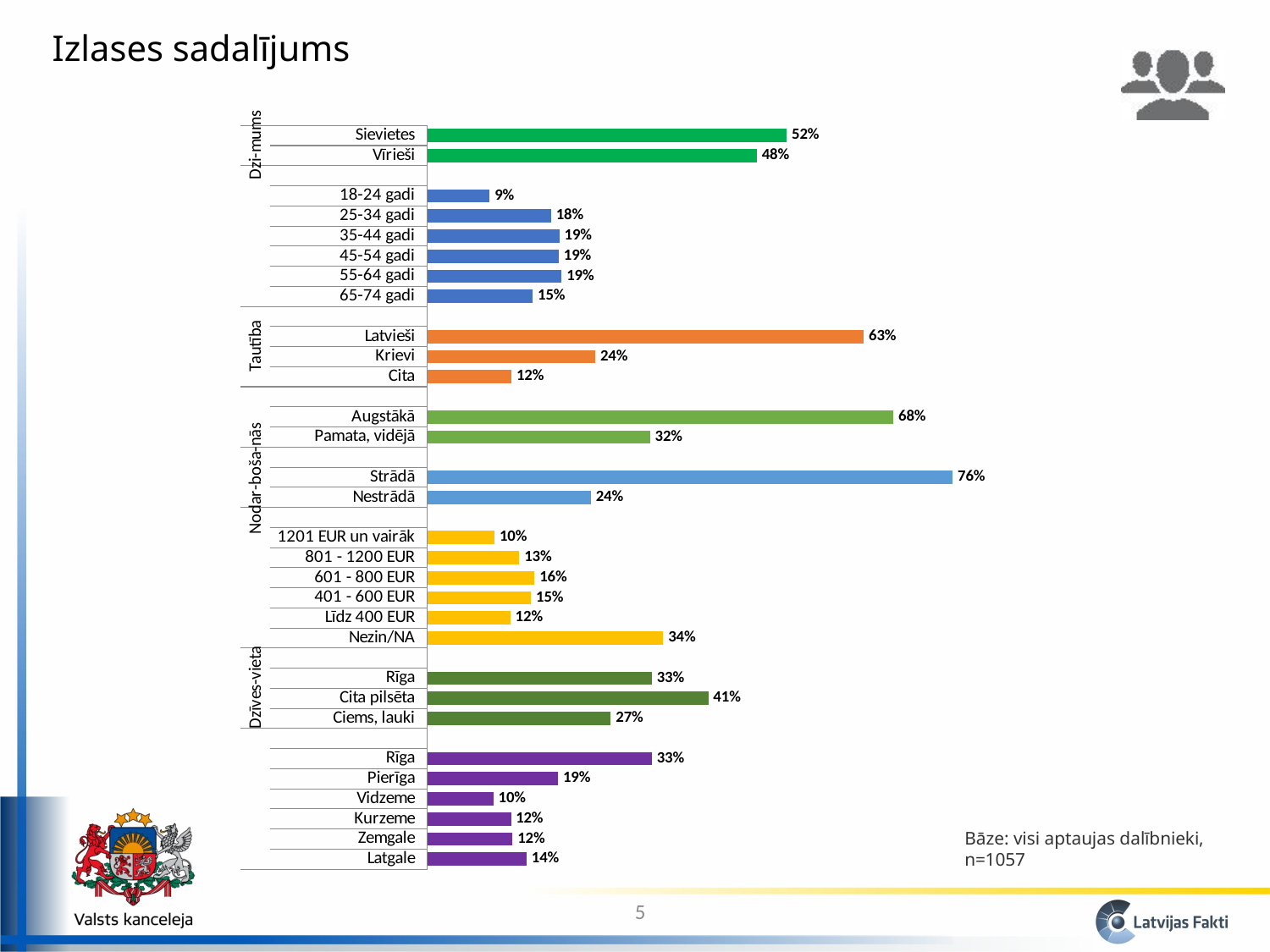
What is the value for Strādā? 76% How many bars are plotted in the chart in total? 30 What kind of chart is shown on the slide? bar chart Which age group (gadi) has the lowest value? 18-24 gadi What is the value for Nezin/NA? 34% Which category has the highest value in the whole chart? Strādā What is the value for Sievietes? 52% What is the title of the slide's chart? Izlases sadalījums Which is larger, Cita pilsēta or Ciems, lauki? Cita pilsēta What is the difference between Latvieši and Krievi? 39% What is the difference between Augstākā and Pamata, vidējā? 36% What is the value for Latvieši? 63%